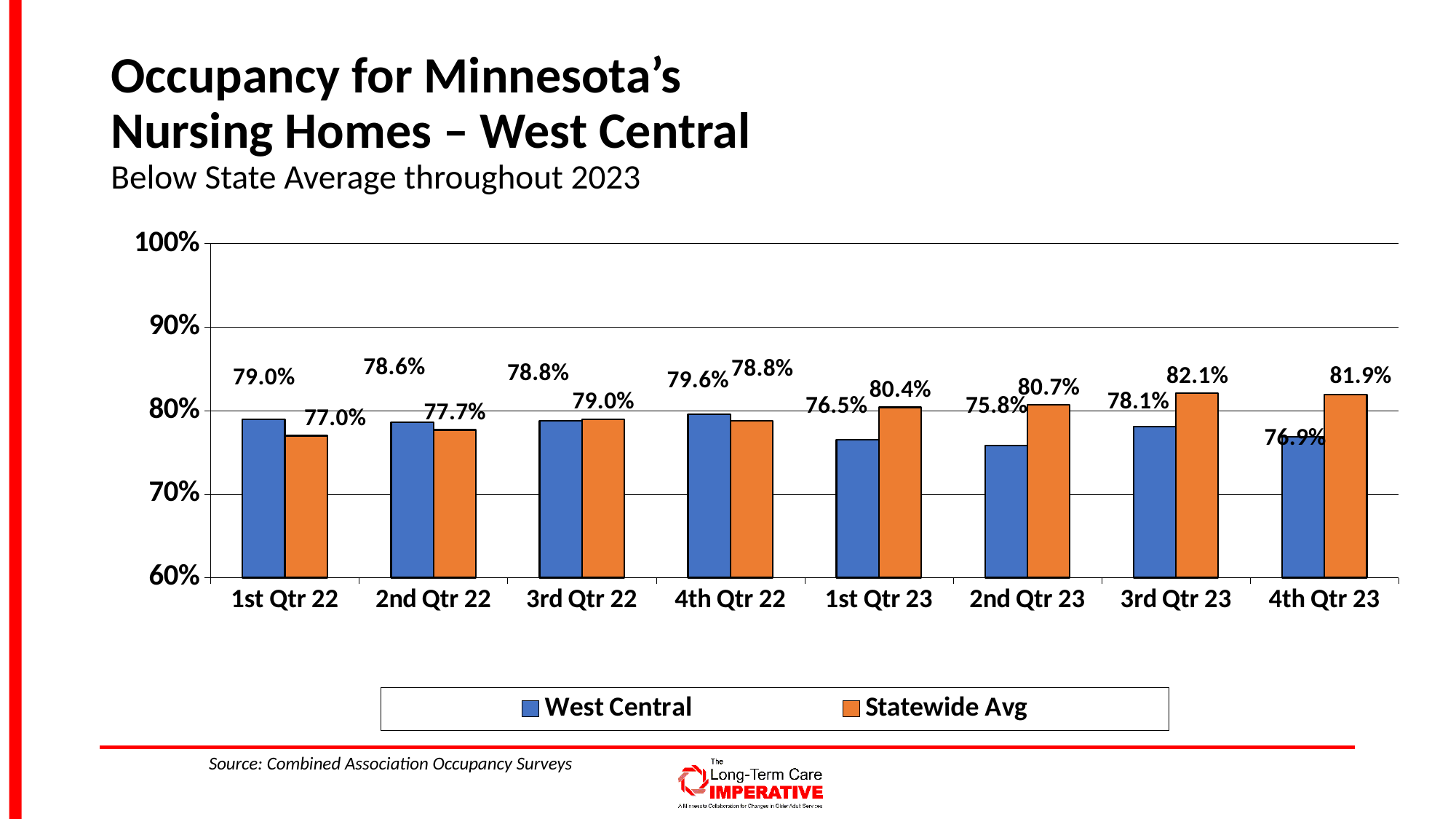
What is the West Central occupancy value for 1st Qtr 23? 76.5% How many quarters are shown on the x axis? 8 What is the difference between the Statewide Avg and West Central values in 2nd Qtr 23? 4.9% What is the Statewide Avg occupancy value for 3rd Qtr 23? 82.1% Which quarter has the highest Statewide Avg value? 3rd Qtr 23 What is the West Central occupancy value for 4th Qtr 22? 79.6% How many series does the legend list? 2 What kind of chart is shown on the slide? Bar chart Which colour represents the Statewide Avg series? Orange In 1st Qtr 22, which is larger: West Central or Statewide Avg? West Central Is the Statewide Avg value for 4th Qtr 23 greater or less than 80%? greater Which quarter has the lowest West Central value? 2nd Qtr 23